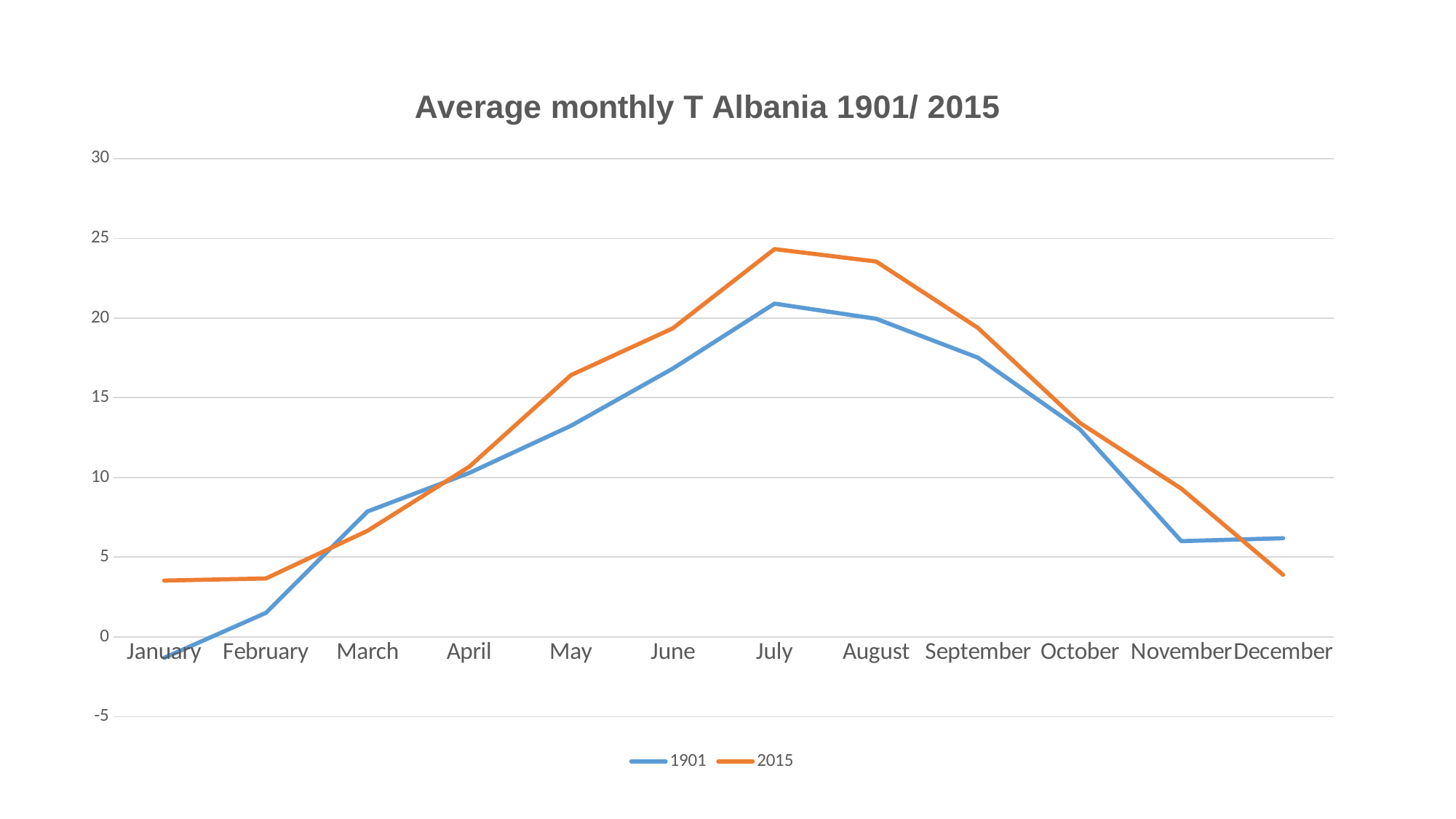
Which series has the larger value in March, 1901 or 2015? 1901 How many months are plotted along the x axis? 12 How many series does the legend list? 2 Which series has the larger value in July, 1901 or 2015? 2015 Is the value for January in the 1901 series greater or less than 0? less In which month does the 1901 series reach its highest value? July In which month does the 2015 series reach its highest value? July Is the value for November in the 1901 series greater or less than 10? less What kind of chart is shown on the slide? line chart In which month does the 1901 series reach its lowest value? January What is the title of the chart? Average monthly T Albania 1901/ 2015 Is the value for July in the 2015 series greater or less than 20? greater